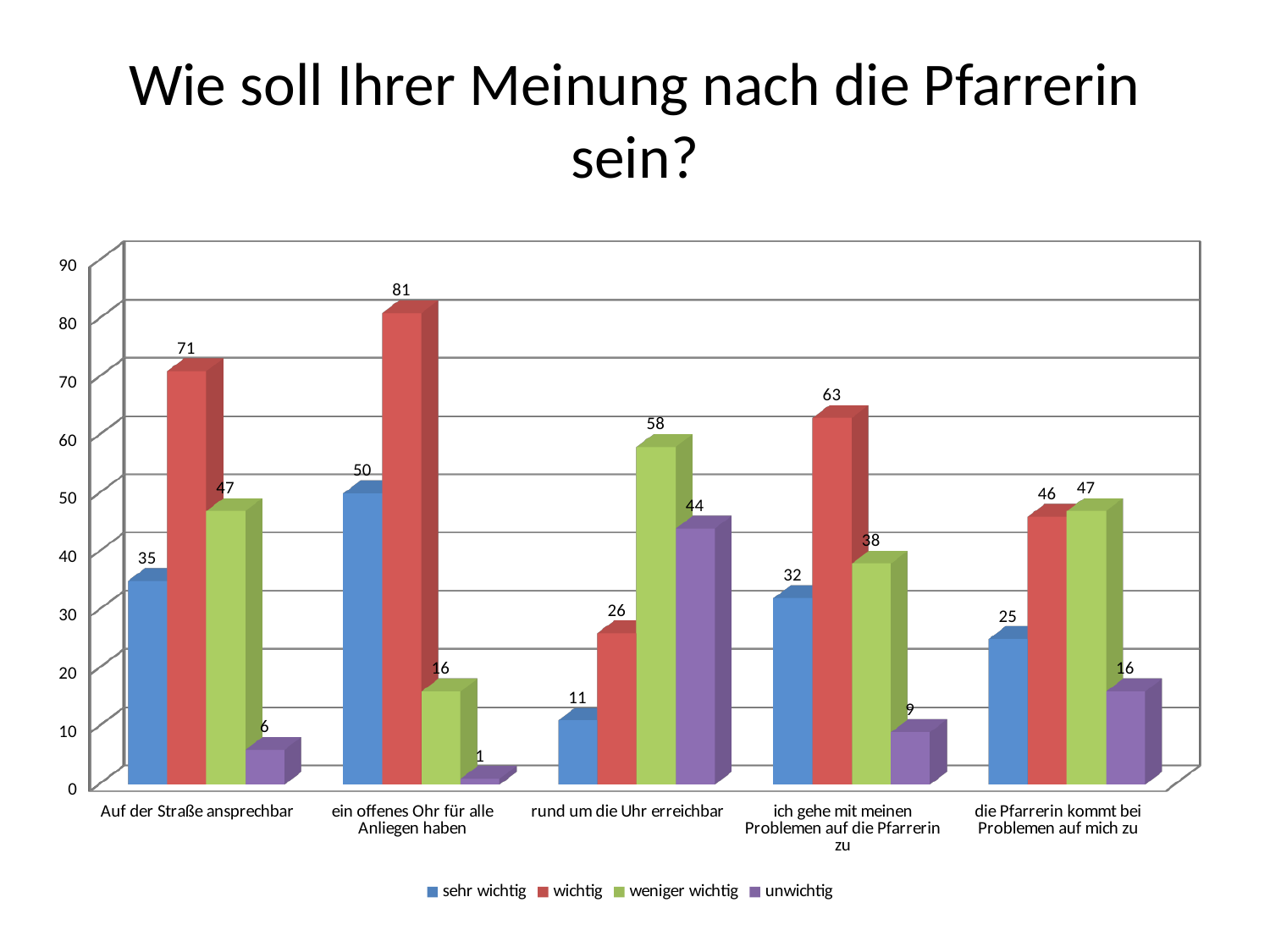
What is the difference between the "wichtig" and "sehr wichtig" values for "Auf der Straße ansprechbar"? 36 What is the value for "unwichtig" in the category "rund um die Uhr erreichbar"? 44 Which category has the lowest value for "sehr wichtig"? rund um die Uhr erreichbar How many series does the legend list? 4 How many categories are shown on the x axis? 5 What is the title of the slide? Wie soll Ihrer Meinung nach die Pfarrerin sein? What kind of chart is shown on the slide? bar chart What is the value for "sehr wichtig" in the category "die Pfarrerin kommt bei Problemen auf mich zu"? 25 Which is larger for "ich gehe mit meinen Problemen auf die Pfarrerin zu": "wichtig" or "weniger wichtig"? wichtig Which category has the highest value for "wichtig"? ein offenes Ohr für alle Anliegen haben Which colour represents the series "weniger wichtig"? green What is the value for "wichtig" in the category "ein offenes Ohr für alle Anliegen haben"? 81